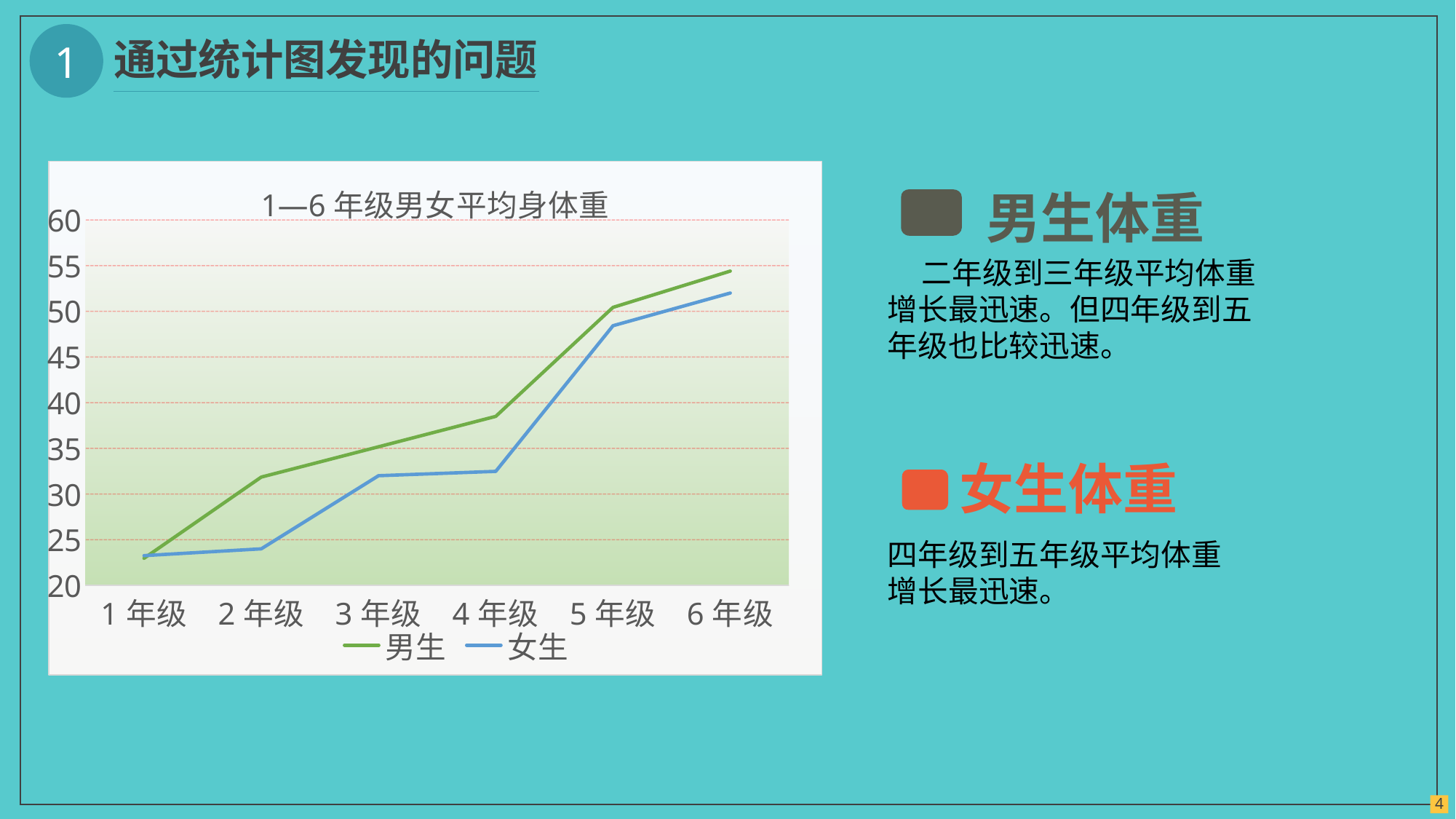
Which series is drawn in green? 男生 Is the value for 女生 at 3 年级 greater or less than 30? greater At 4 年级, which series has the higher value, 男生 or 女生? 男生 At which grade does the 男生 series reach its highest value? 6 年级 Is the value for 女生 at 2 年级 greater or less than 25? less Is the value for 男生 at 6 年级 greater or less than 50? greater How many series does the legend list? 2 Do the values for 女生 generally rise or fall from 1 年级 to 6 年级? rise How many grade categories are shown on the x axis? 6 What kind of chart is shown on the slide? line chart What is the title of the chart? 1—6 年级男女平均身体重